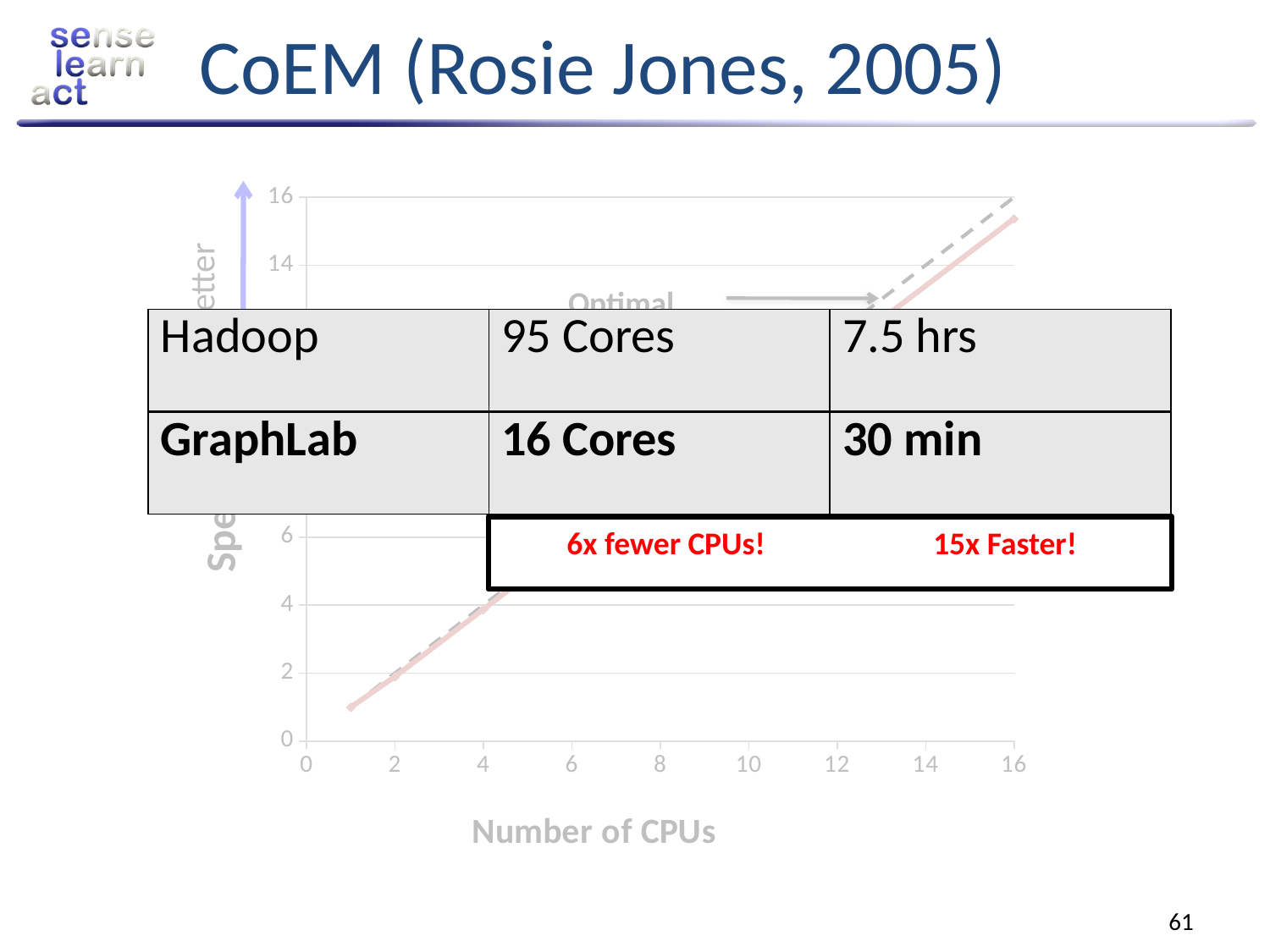
Is the value of the solid line at 16 CPUs greater or less than 16? less Is the value of the solid line at 1 CPU greater or less than 2? less Does the plotted speedup line rise or fall as the number of CPUs increases? rises What is the title of the x axis of the chart? Number of CPUs Is the value of the solid line at 16 CPUs greater or less than 14? greater What kind of chart is shown on the slide? line chart What is the highest value shown on the x axis of the chart? 16